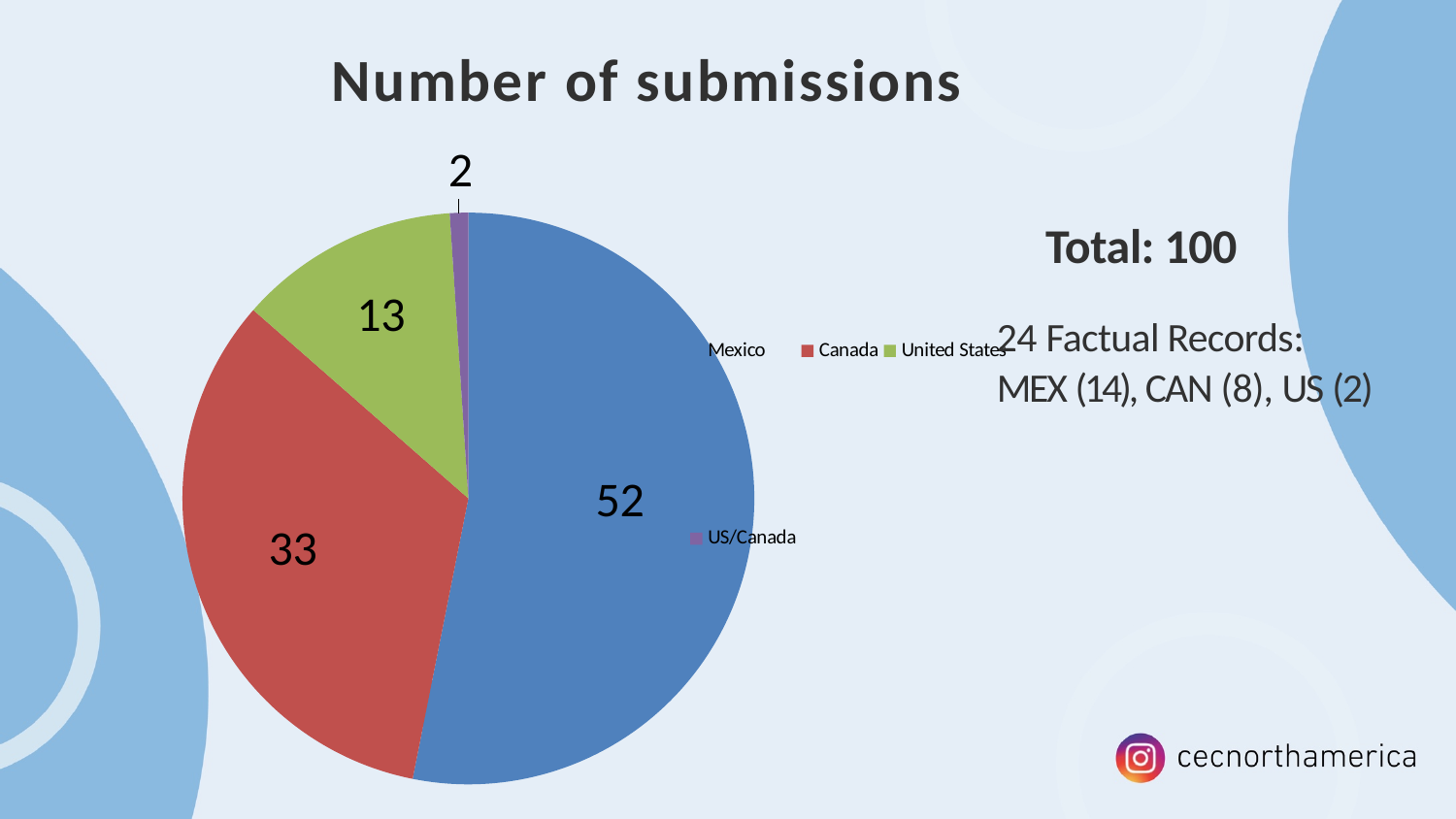
Which has more submissions, Canada or United States? Canada What is the number of submissions for US/Canada? 2 What is the difference between the submissions for Mexico and Canada? 19 What is the number of submissions for United States? 13 What is the number of submissions for Mexico? 52 What kind of chart is shown on the slide? Pie chart Which category has the largest slice of the pie? Mexico What is the number of submissions for Canada? 33 What share of the total submissions does Mexico account for? 52% What is the title of the chart? Number of submissions Which category has the smallest slice of the pie? US/Canada How many categories does the pie chart have? 4